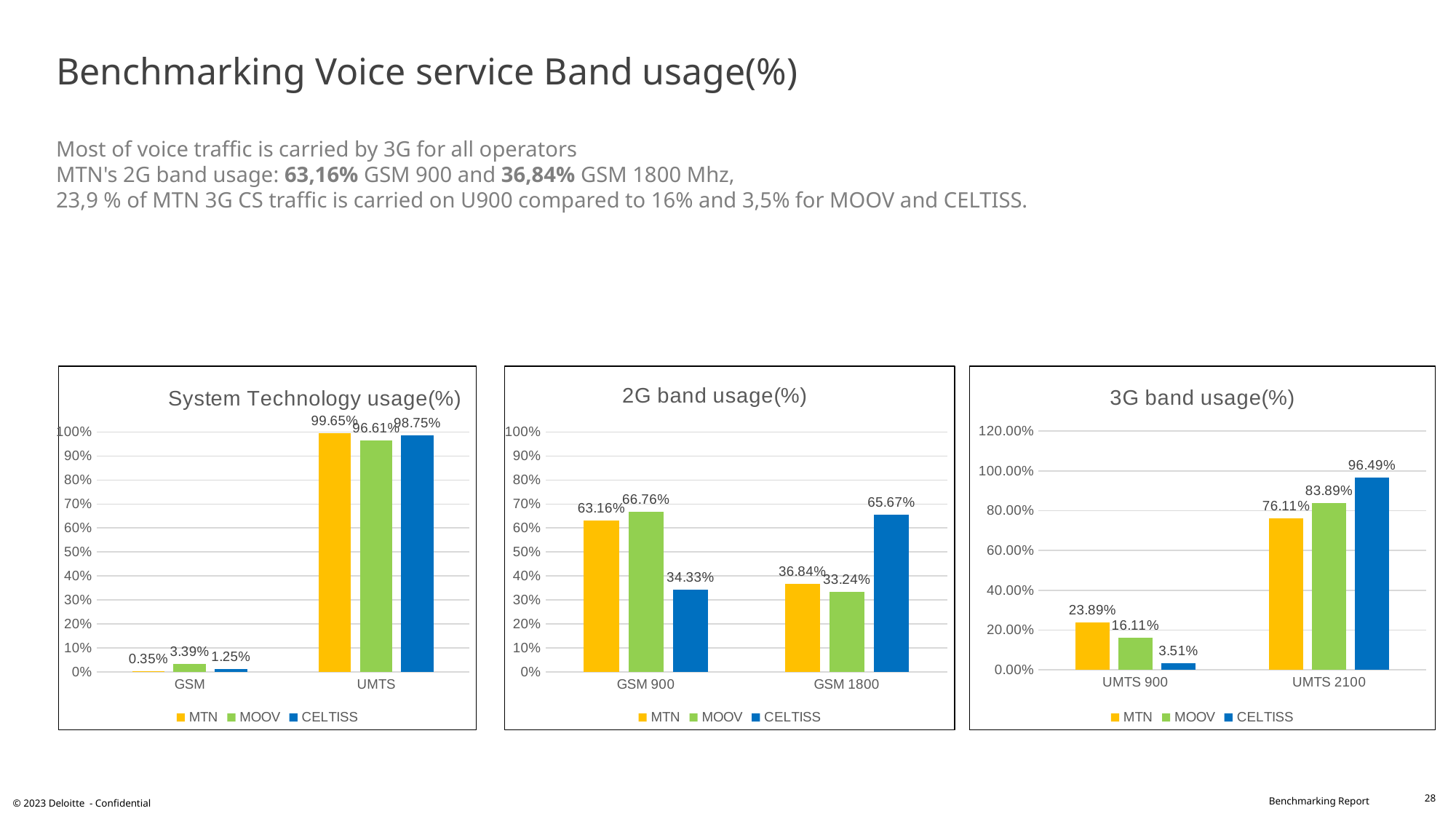
In the '3G band usage(%)' chart, is the value for MTN under UMTS 900 greater or less than 20.00%? greater In the 'System Technology usage(%)' chart, what is the value for MTN under UMTS? 99.65% In the '3G band usage(%)' chart, which is larger: MOOV under UMTS 900 or MTN under UMTS 900? MTN under UMTS 900 How many series does the legend of the '2G band usage(%)' chart list? 3 What kind of chart is the '3G band usage(%)' chart? Bar chart In the 'System Technology usage(%)' chart, what is the value for MOOV under GSM? 3.39% In the '2G band usage(%)' chart, which operator has the highest value under GSM 900? MOOV In the '2G band usage(%)' chart, what is the value for CELTISS under GSM 1800? 65.67% How many categories are shown on the x axis of the 'System Technology usage(%)' chart? 2 In the '2G band usage(%)' chart, what is the difference between MTN's GSM 900 and GSM 1800 values? 26.32% In the '3G band usage(%)' chart, which operator has the lowest value under UMTS 2100? MTN In the '3G band usage(%)' chart, what is the value for CELTISS under UMTS 900? 3.51%